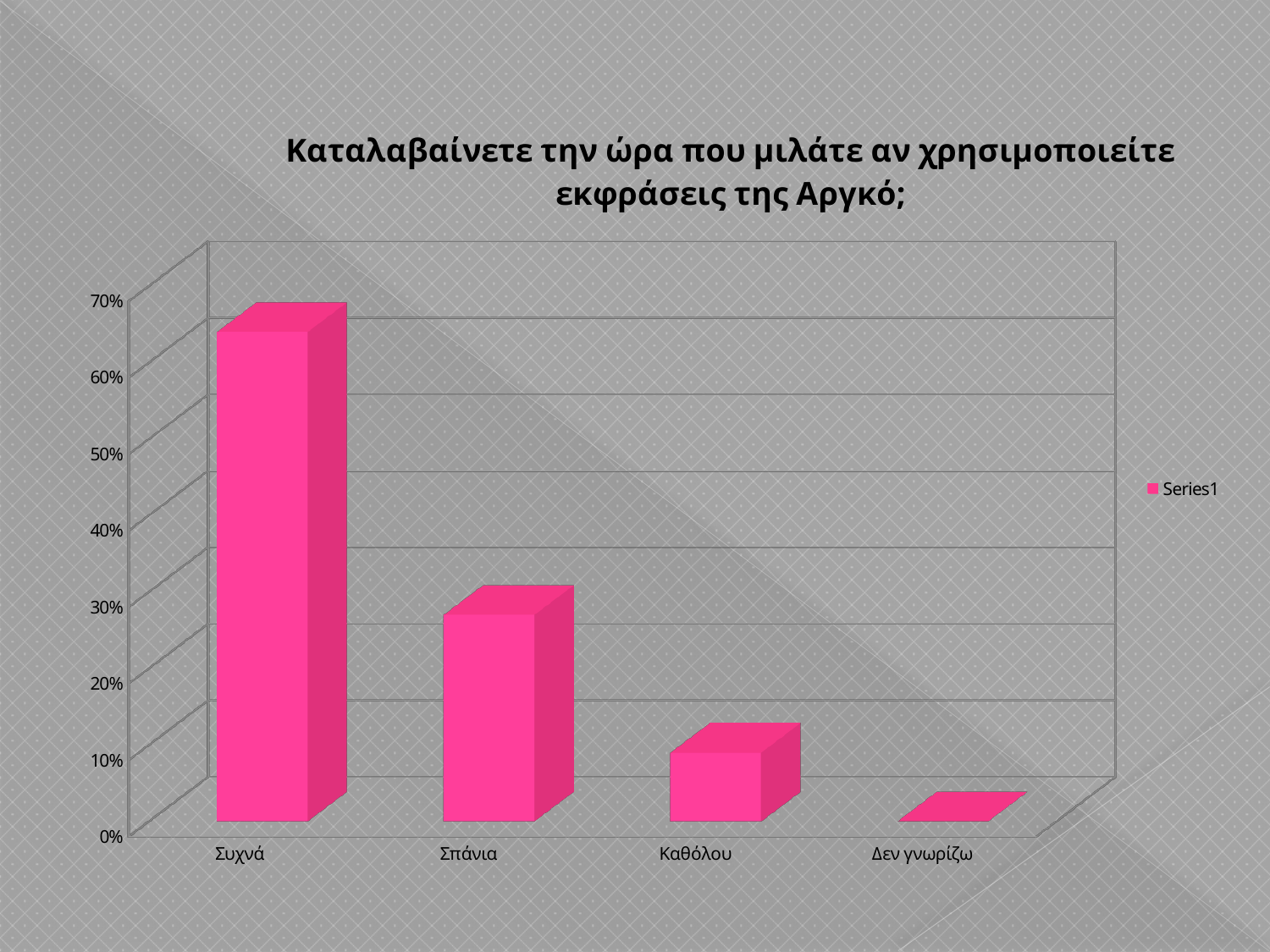
Which is larger, the value for Συχνά or the value for Σπάνια? Συχνά Which category has the highest value in the chart? Συχνά Do the values rise or fall moving from left to right along the x axis? fall How many series does the chart's legend list? 1 Is the value for Σπάνια greater or less than 20%? greater What is the name of the series listed in the chart's legend? Series1 Is the value for Καθόλου greater or less than 20%? less Is the value for Συχνά greater or less than 60%? greater How many categories are shown on the x axis of the chart? 4 What kind of chart is shown on the slide? bar chart Which category has the lowest value in the chart? Δεν γνωρίζω Which is larger, the value for Καθόλου or the value for Σπάνια? Σπάνια